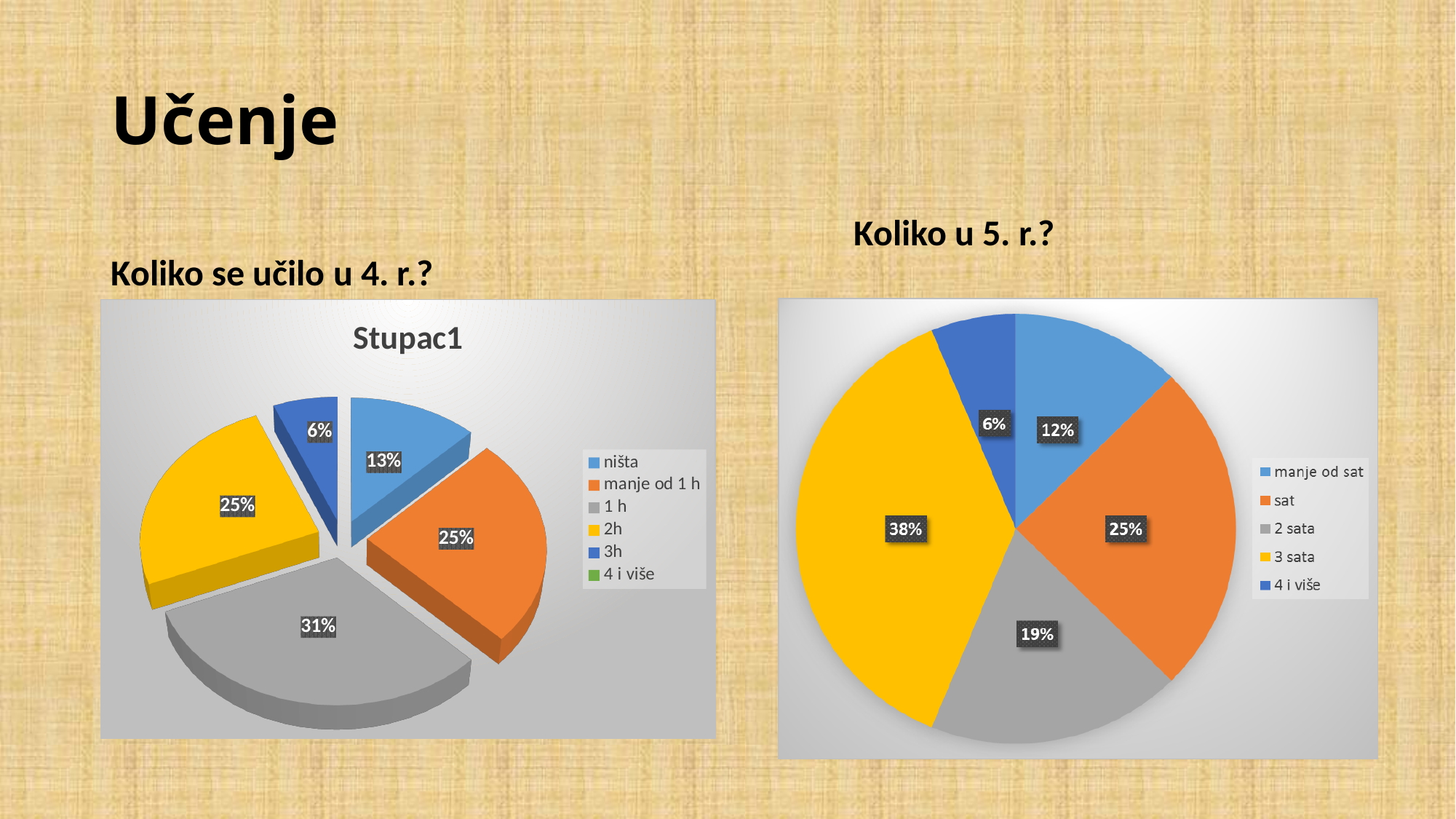
In the right chart (Koliko u 5. r.?), what is the difference between the '3 sata' slice and the 'manje od sat' slice? 26% In the left chart (Stupac1), what is the difference between the '1 h' slice and the '3h' slice? 25% In the left chart (Stupac1), which category has the largest slice? 1 h In the left chart (Stupac1), how many entries does the legend list? 6 In the left chart (Stupac1), what share of the pie is the '1 h' slice? 31% In the right chart (Koliko u 5. r.?), what colour is the '3 sata' slice? Yellow In the left chart (Stupac1), which labelled slice is the smallest? 3h What kind of chart is the right chart titled 'Koliko u 5. r.?'? Pie chart In the right chart (Koliko u 5. r.?), which is larger: 'sat' or '2 sata'? sat In the right chart (Koliko u 5. r.?), which category has the smallest slice? 4 i više In the right chart (Koliko u 5. r.?), what percentage is shown for '3 sata'? 38% In the left chart (Stupac1), what percentage is shown for 'ništa'? 13%